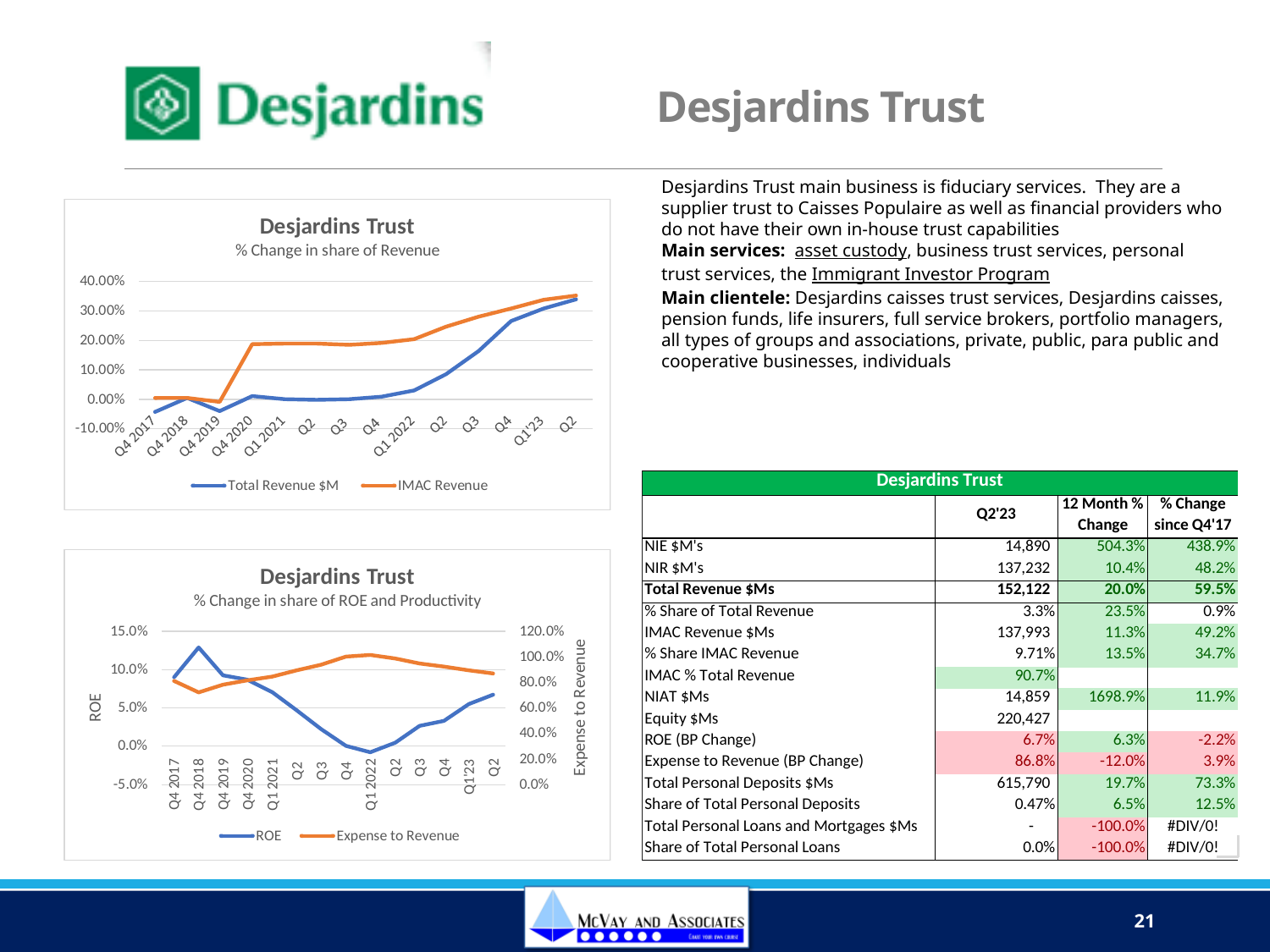
In the bottom chart (% Change in share of ROE and Productivity), at which x-axis point is ROE lowest? Q1 2022 In the top chart (% Change in share of Revenue), is the value for IMAC Revenue at Q4 2020 greater or less than 10.00%? greater In the top chart (% Change in share of Revenue), which series is higher at Q4 2020, Total Revenue $M or IMAC Revenue? IMAC Revenue In the top chart (% Change in share of Revenue), how many points are shown along the x axis? 14 In the bottom chart (% Change in share of ROE and Productivity), at which x-axis point is ROE highest? Q4 2018 In the top chart (% Change in share of Revenue), is the value for Total Revenue $M at Q4 2017 greater or less than 0.00%? less What kind of chart is the top chart titled 'Desjardins Trust % Change in share of Revenue'? line chart In the bottom chart (% Change in share of ROE and Productivity), is the value for Expense to Revenue at Q4 2021 greater or less than 80.0%? greater How many series does the legend of the top chart (% Change in share of Revenue) list? 2 What are the two legend entries in the bottom chart (% Change in share of ROE and Productivity)? ROE and Expense to Revenue In the top chart (% Change in share of Revenue), does Total Revenue $M generally rise or fall from Q1 2022 to Q2 at the end of the axis? rise